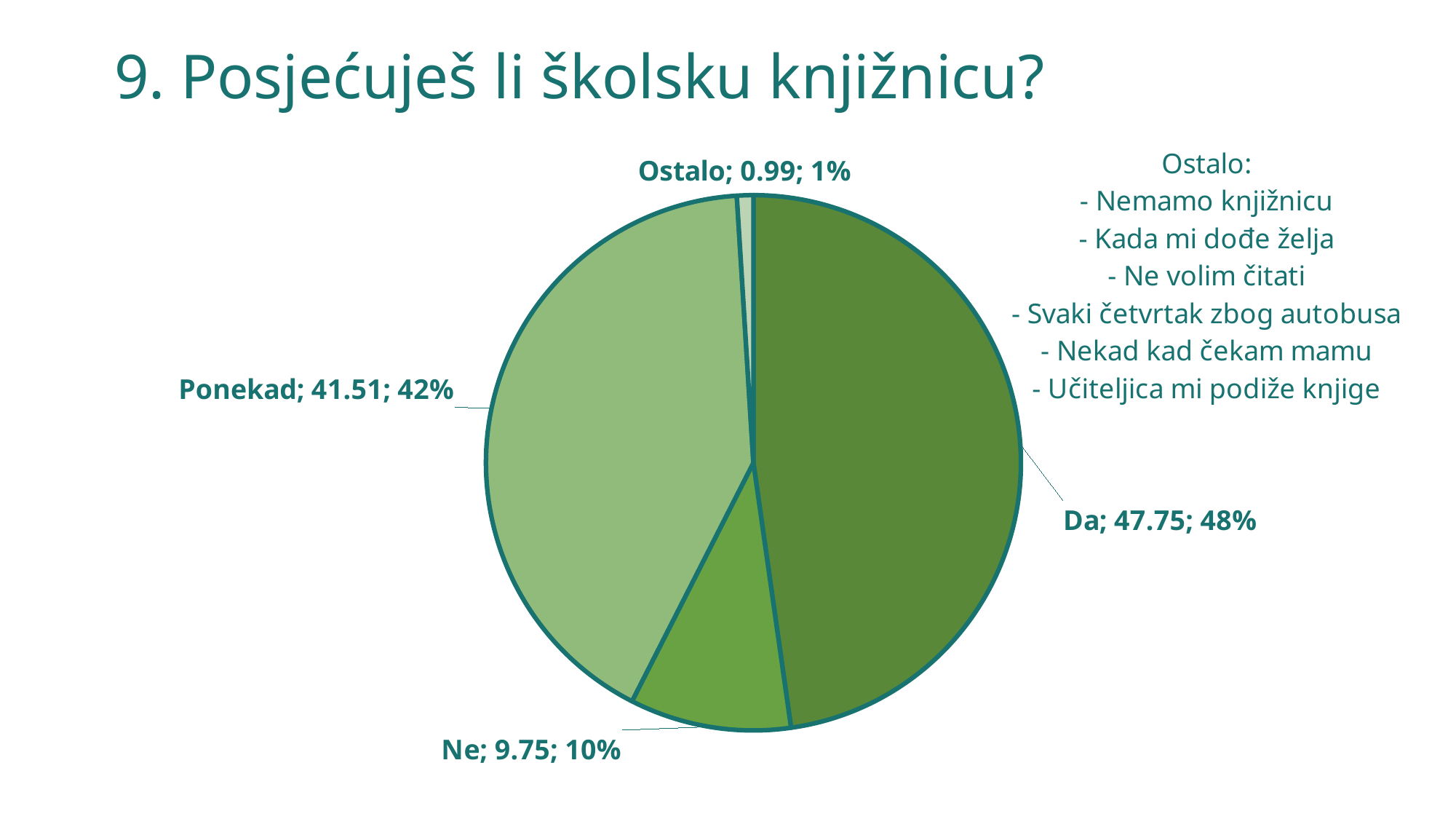
Which category has the largest slice? Da What is the value for Ne? 9.75 What is the value for Ostalo? 0.99 What percentage share of the pie does Ponekad have? 42% What is the value for Da? 47.75 What percentage share of the pie does Ne have? 10% What is the difference between the values for Da and Ponekad? 6.24 What kind of chart is shown on the slide? pie chart Which category has the smallest slice? Ostalo What is the value for Ponekad? 41.51 How many slices does the pie chart have? 4 Which is larger, the value for Ne or the value for Ostalo? Ne